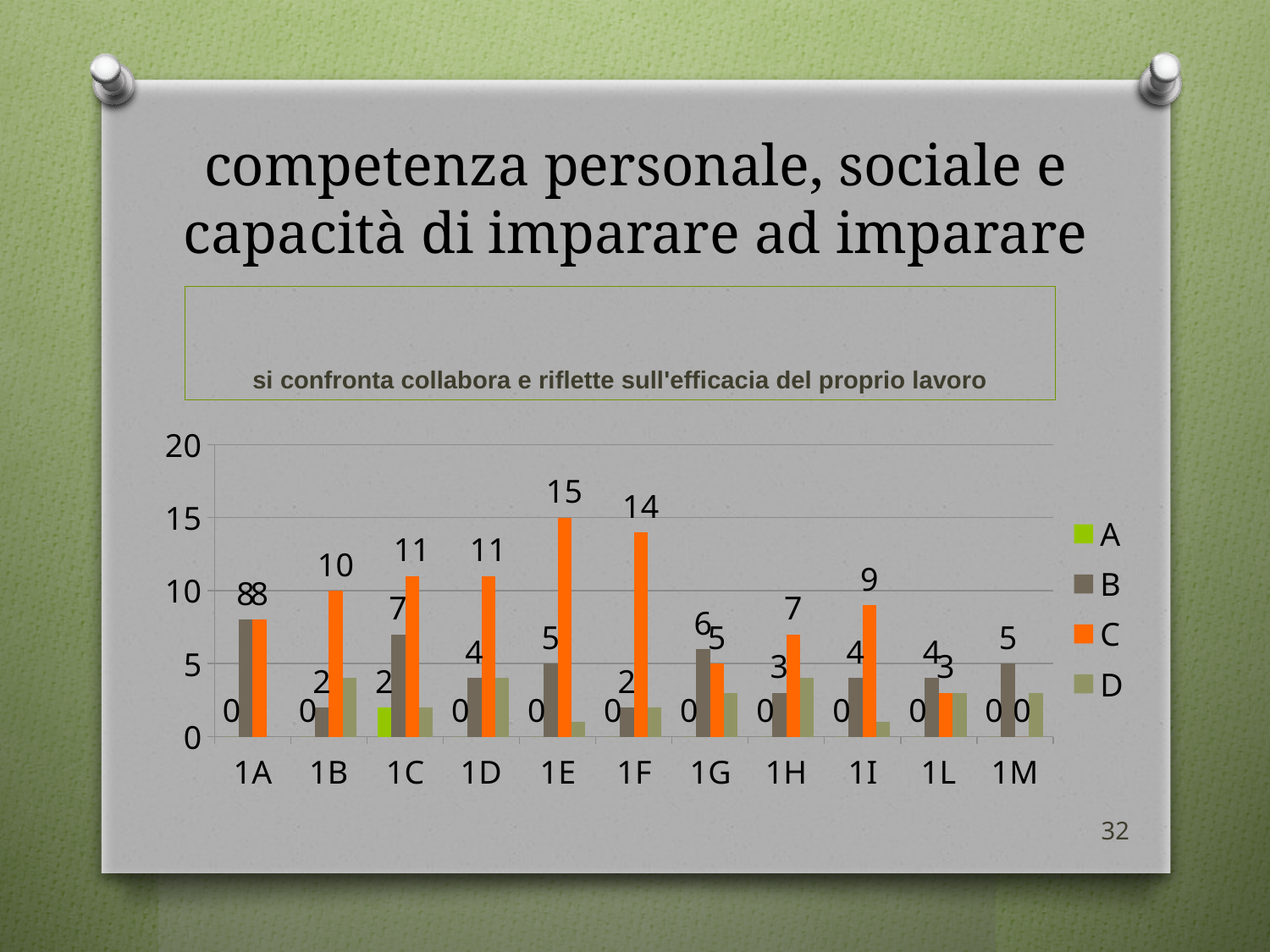
What is the difference between the series C values for 1E and 1F? 1 What is the value of series A for category 1C? 2 Which category has the highest value for series C? 1E What is the value of series C for category 1M? 0 How many series does the legend list? 4 What kind of chart is shown on the slide? bar chart Is the value of series D for category 1E greater or less than 5? less Which category has the larger series B value, 1C or 1D? 1C What is the value of series B for category 1G? 6 How many categories are shown on the x axis? 11 What is the value of series C for category 1E? 15